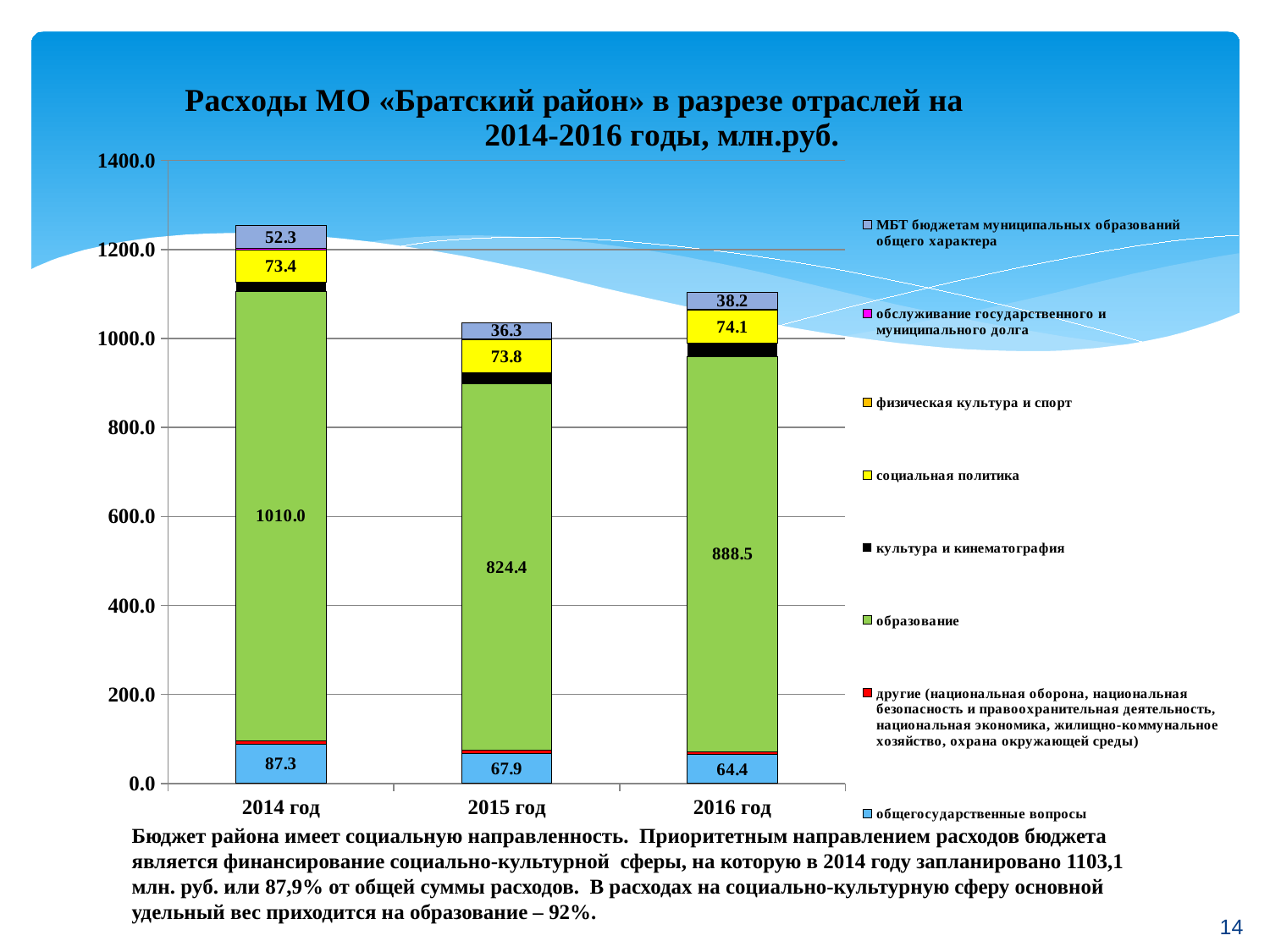
What is the value for социальная политика in 2015 год? 73.8 In which year is the value for общегосударственные вопросы the lowest? 2016 год How many years are shown on the x axis? 3 What is the difference between the образование values for 2016 год and 2015 год? 64.1 Which is larger: the МБТ value for 2015 год or for 2016 год? 2016 год What is the value for общегосударственные вопросы in 2016 год? 64.4 In which year is the value for образование the highest? 2014 год What kind of chart is shown on the slide? stacked bar chart How many series does the legend list? 8 What is the value for МБТ бюджетам муниципальных образований общего характера in 2014 год? 52.3 Is the total height of the 2015 год bar greater or less than 1200.0? less What is the value for образование in 2014 год? 1010.0